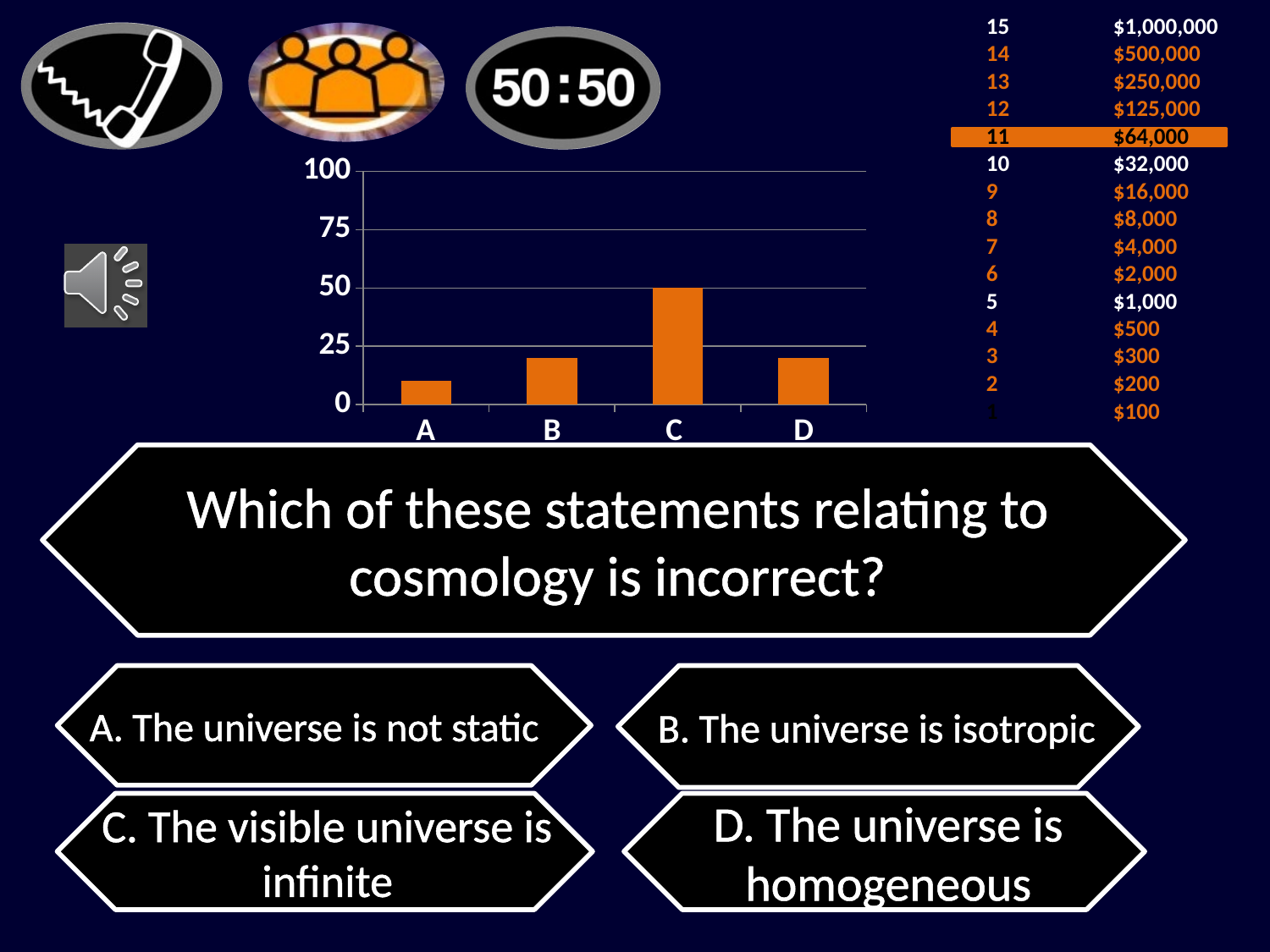
Which category has the highest bar in the chart? C Is the value for A greater or less than 25? less Which is larger, the value for C or the value for A? C What is the highest value shown on the y axis of the chart? 100 Is the value for C greater or less than 75? less Is the value for B greater or less than 25? less Which is larger, the value for B or the value for A? B What kind of chart is shown on the slide? bar chart How many categories are shown on the x axis of the bar chart? 4 Which category has the lowest bar in the chart? A What is the value for category C in the bar chart? 50